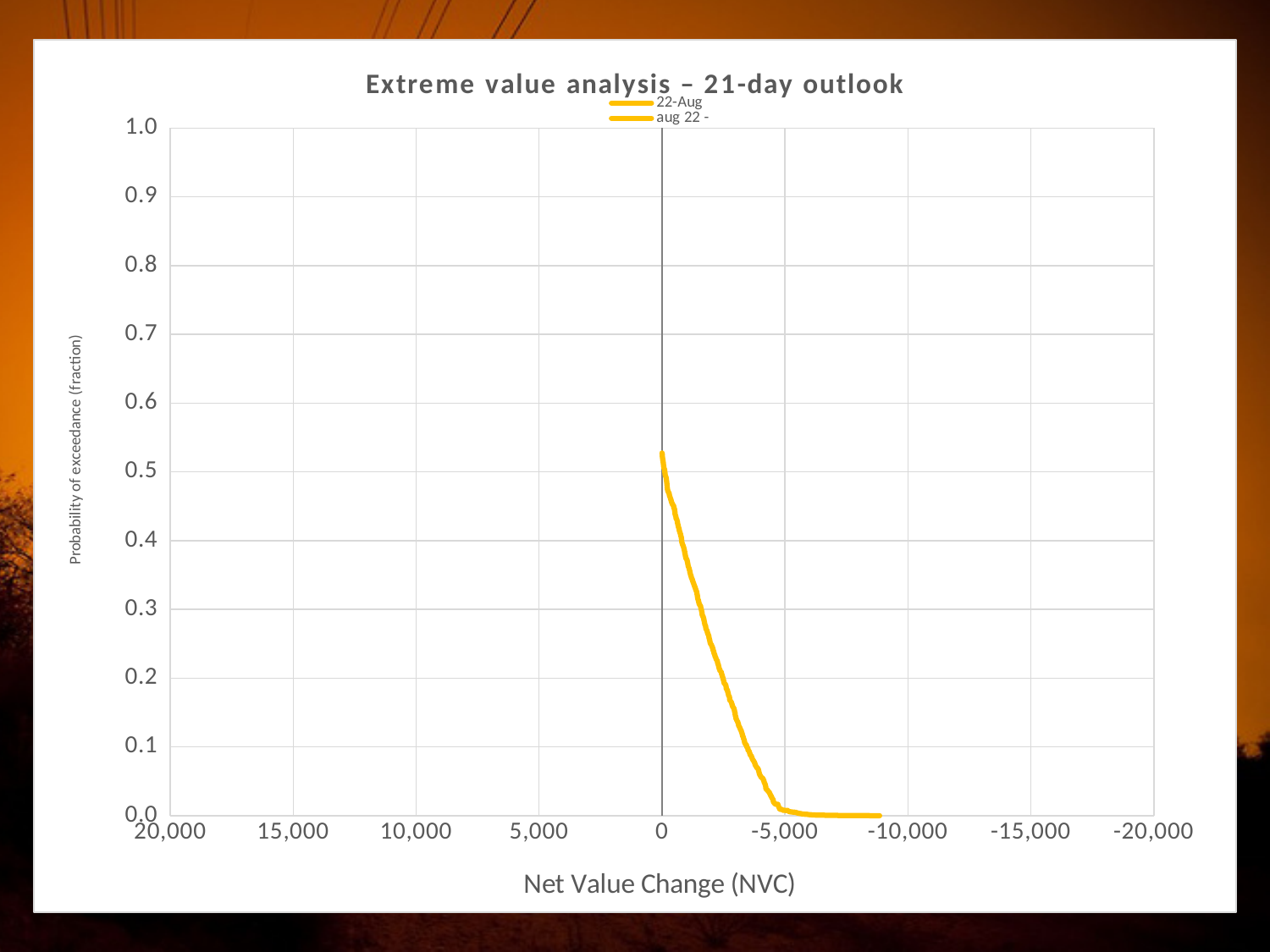
Does the probability of exceedance rise or fall as the curve moves from a Net Value Change of 0 toward -10,000? fall Which has the higher probability of exceedance: a Net Value Change of 0 or of -5,000? 0 What is the highest value shown on the y axis? 1.0 How many entries does the chart's legend list? 2 Is the probability of exceedance at a Net Value Change of 0 greater or less than 0.5? greater What is the label of the x axis? Net Value Change (NVC) Is the probability of exceedance at a Net Value Change of -5,000 greater or less than 0.1? less At which Net Value Change tick does the curve reach its highest probability of exceedance? 0 What is the title of the chart? Extreme value analysis – 21-day outlook What kind of chart is shown on the slide? line chart Is the probability of exceedance at a Net Value Change of 0 greater or less than 0.6? less